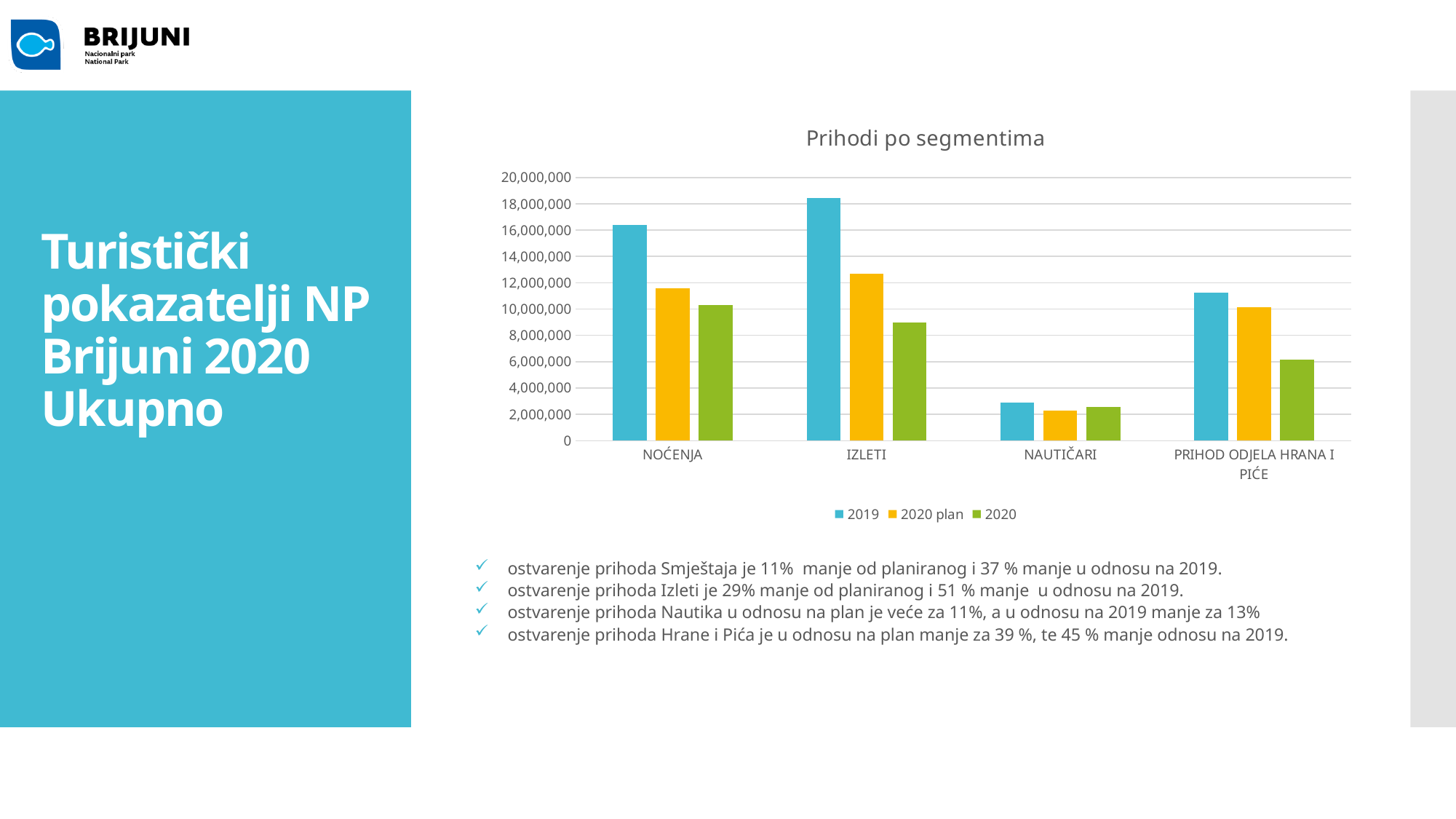
Is the 2019 value for NOĆENJA greater or less than 14,000,000? greater Is the 2020 value for PRIHOD ODJELA HRANA I PIĆE greater or less than 4,000,000? greater Which is larger: the 2019 value for IZLETI or the 2019 value for NOĆENJA? IZLETI Which category has the highest value for the 2020 series? NOĆENJA How many categories are shown on the x axis? 4 What type of chart is shown on the slide? bar chart For NOĆENJA, which is larger: the 2020 plan value or the 2020 value? 2020 plan Which category has the lowest value for the 2019 series? NAUTIČARI How many series does the legend list? 3 Which category has the highest value for the 2019 series? IZLETI What is the title of the chart? Prihodi po segmentima Is the 2020 value for IZLETI greater or less than 10,000,000? less